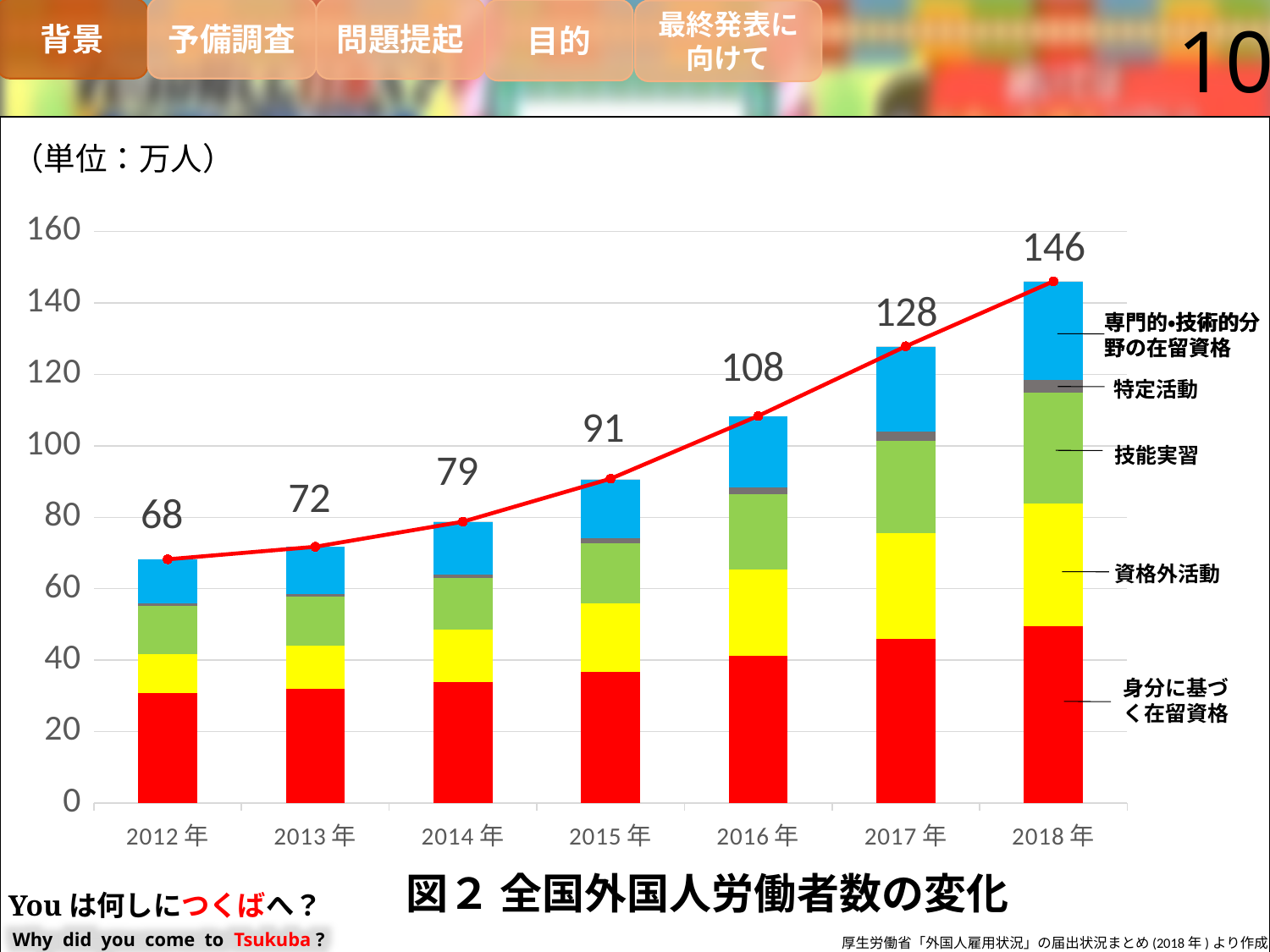
Which year has the highest total number of foreign workers? 2018年 How many years are shown on the x axis? 7 What is the total value shown for 2015? 91 Is the red 身分に基づく在留資格 segment for 2018 greater or less than 40? greater How many categories of residence status are labelled on the stacked bars? 5 What kind of chart is this? Stacked bar chart with a line What is the difference between the totals for 2017 and 2016? 20 Do the totals rise or fall from 2012 to 2018? Rise Which is larger, the total for 2014 or the total for 2013? 2014年 By how much did the total increase from 2012 to 2018? 78 Which year has the lowest total number of foreign workers? 2012年 What is the total number of foreign workers shown for 2018? 146